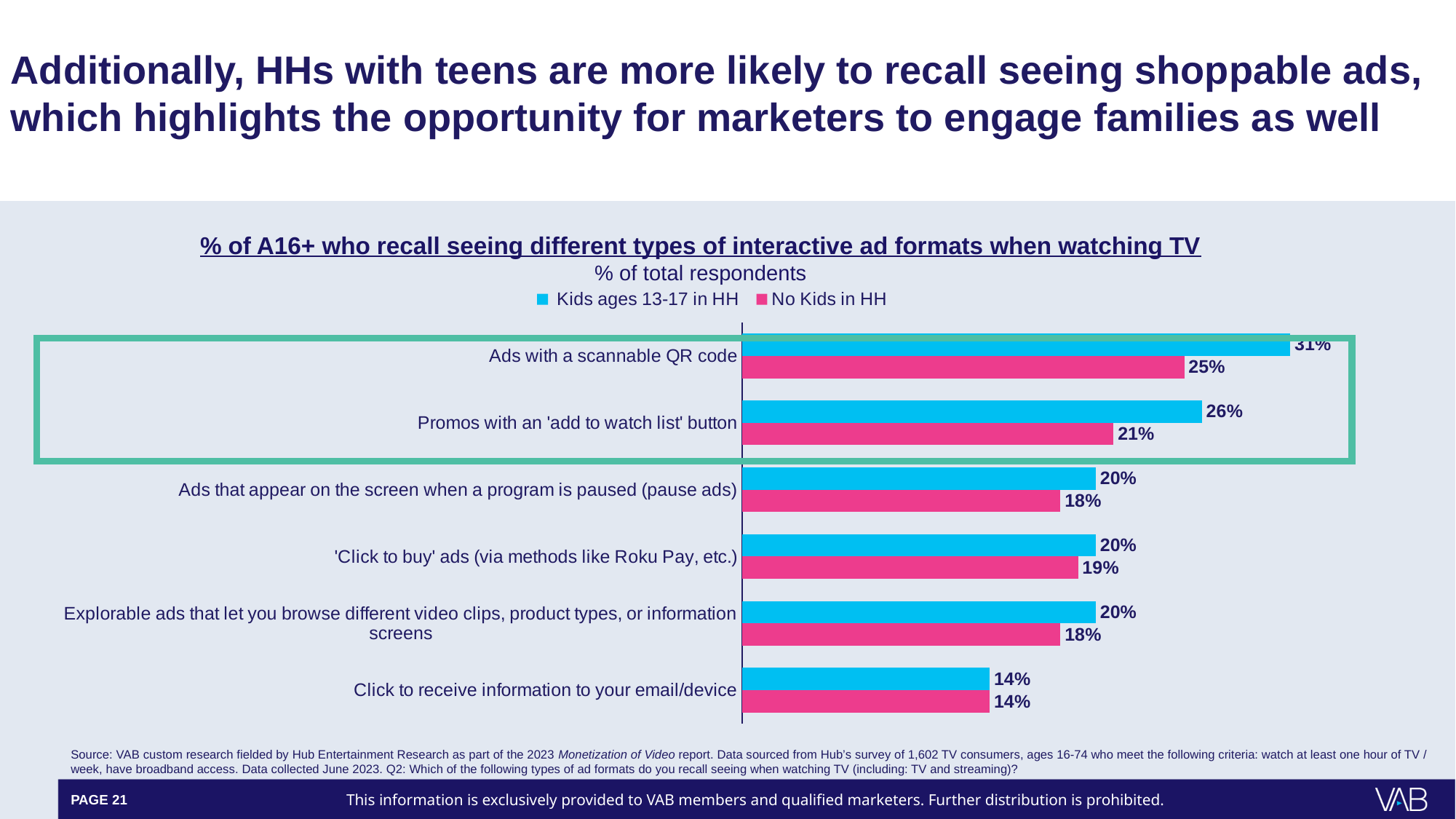
What percentage of households with kids ages 13-17 recall seeing ads with a scannable QR code? 31% Which colour represents the 'No Kids in HH' series? Pink How many ad format categories are shown in the chart? 6 What is the difference between the two series for promos with an 'add to watch list' button? 5 percentage points For pause ads, which group has the higher recall: Kids ages 13-17 in HH or No Kids in HH? Kids ages 13-17 in HH What is the value for 'No Kids in HH' for 'Click to buy' ads? 19% What is the difference between the Kids ages 13-17 in HH and No Kids in HH values for ads with a scannable QR code? 6 percentage points How many series does the legend list? 2 What percentage of households with no kids recall seeing promos with an 'add to watch list' button? 21% Which ad format has the highest recall among households with kids ages 13-17? Ads with a scannable QR code Which ad format has the lowest recall among households with no kids? Click to receive information to your email/device What type of chart is shown on the slide? Bar chart